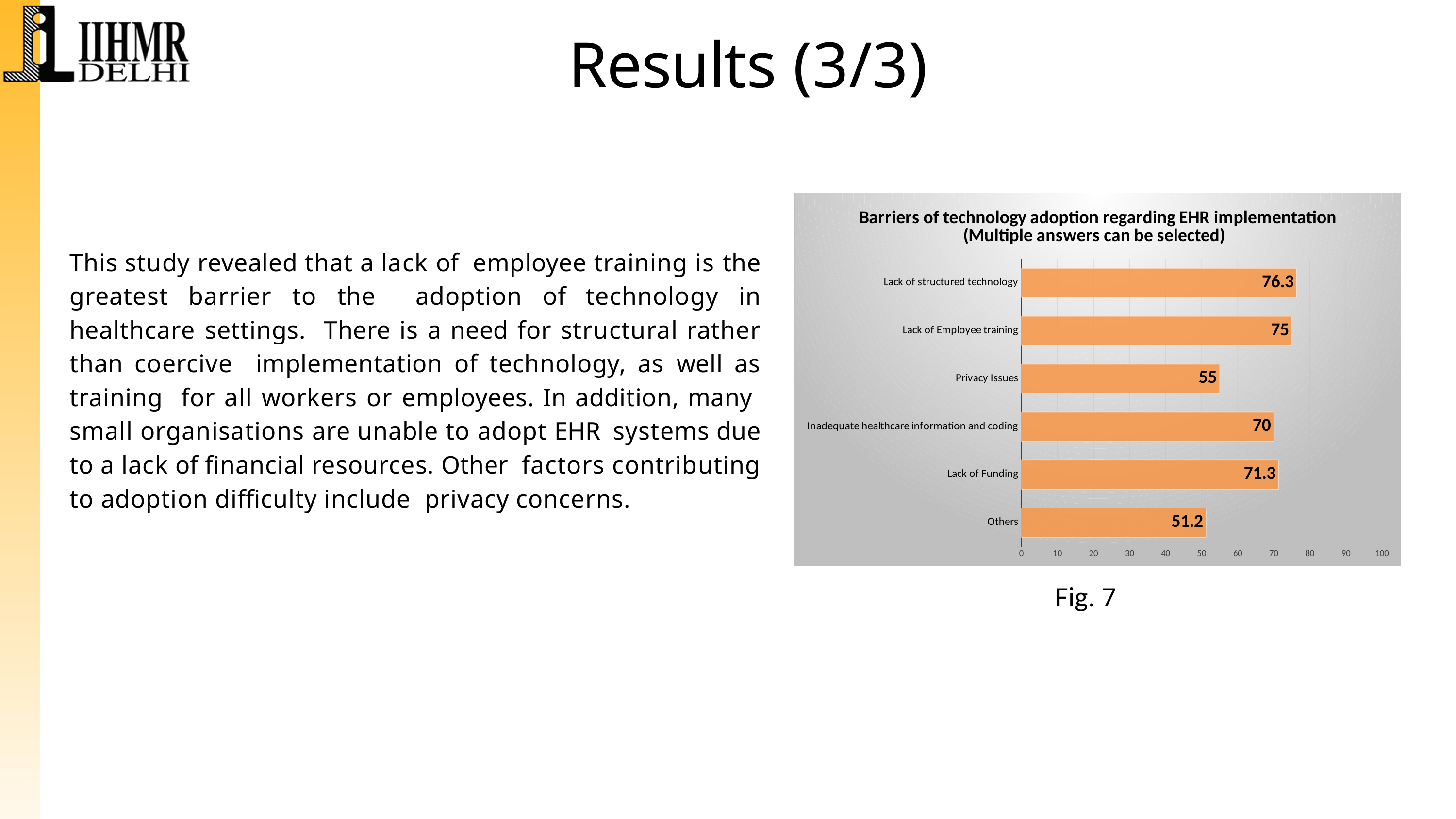
What kind of chart is shown on the slide? bar chart What is the value for Lack of structured technology? 76.3 Which is larger, the value for Lack of Funding or the value for Inadequate healthcare information and coding? Lack of Funding What is the value for Lack of Funding? 71.3 What is the difference between the values for Lack of Employee training and Privacy Issues? 20 What is the title of the chart? Barriers of technology adoption regarding EHR implementation (Multiple answers can be selected) Which category has the highest value? Lack of structured technology What is the value for Others? 51.2 How many categories are shown in the chart? 6 What is the value for Privacy Issues? 55 Which category has the lowest value? Others Is the value for Privacy Issues greater or less than 60? less